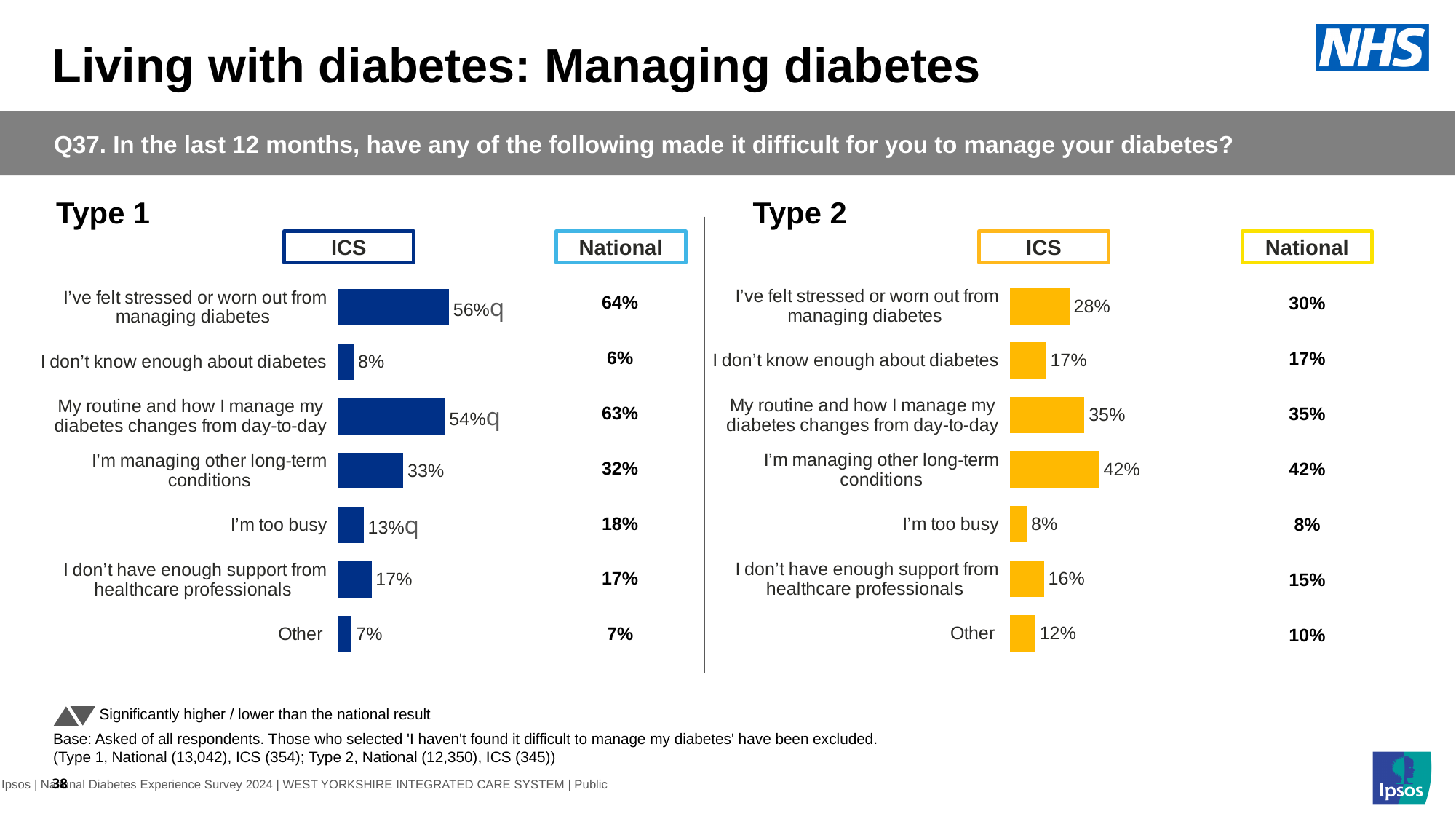
In the Type 2 chart, which category has the lowest ICS value? I'm too busy How many categories are shown in the Type 2 chart? 7 In the Type 1 chart, which category has the highest ICS value? I've felt stressed or worn out from managing diabetes In the Type 2 chart, what is the National value for 'Other'? 10% In the Type 1 chart, what is the difference between the National and ICS values for 'I've felt stressed or worn out from managing diabetes'? 8 percentage points In the Type 2 chart, what is the ICS value for 'I'm managing other long-term conditions'? 42% What type of chart is used for the ICS values in the Type 1 section? Bar chart What colour are the ICS bars in the Type 2 chart? Yellow/orange In the Type 1 chart, which is larger for 'I'm too busy': the ICS value or the National value? National In the Type 2 chart, what is the difference between the ICS and National values for 'Other'? 2 percentage points In the Type 1 chart, what is the ICS value for 'I've felt stressed or worn out from managing diabetes'? 56% In the Type 1 chart, what is the National value for 'My routine and how I manage my diabetes changes from day-to-day'? 63%